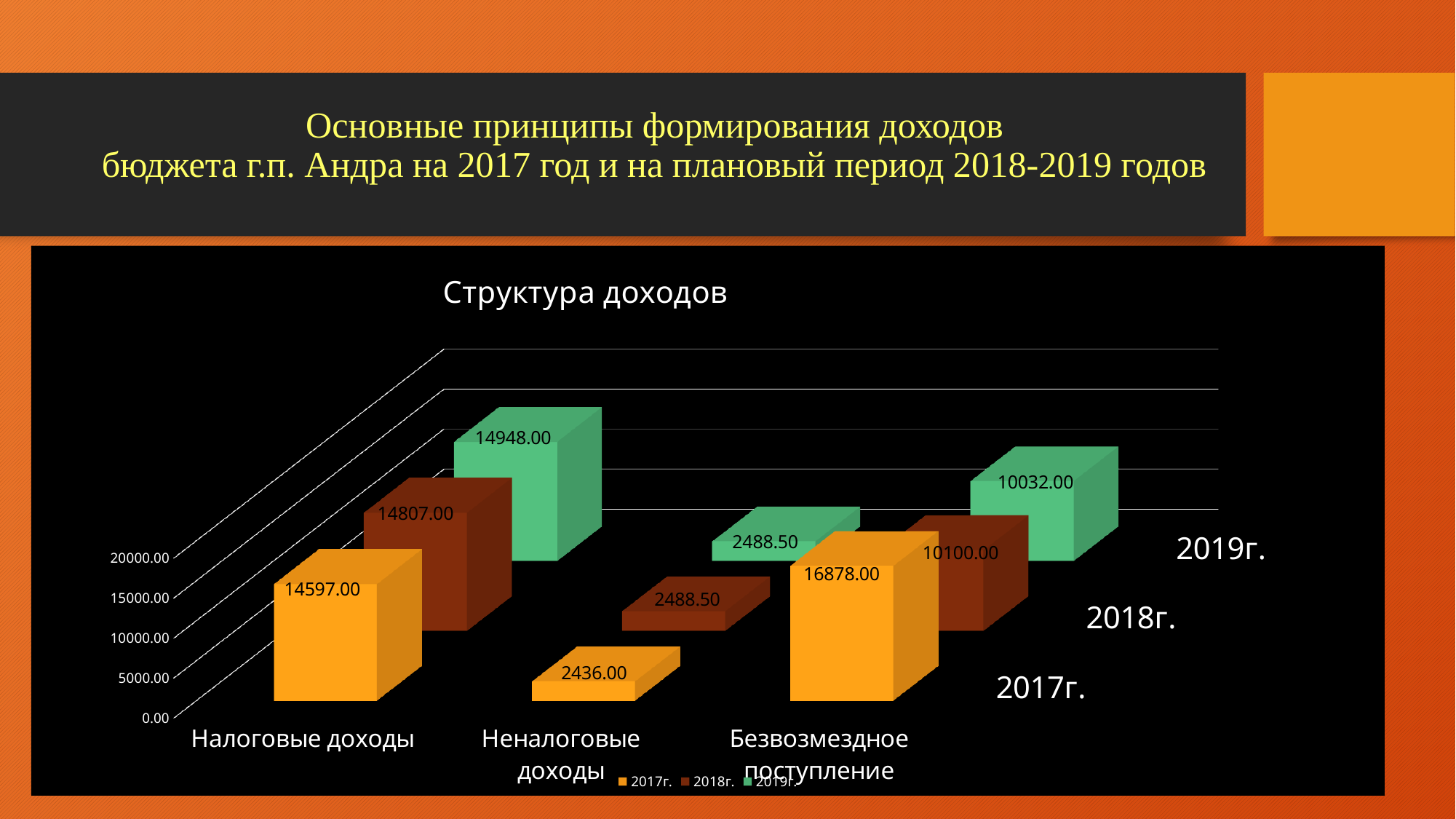
Which category has the lowest value in 2019г.? Неналоговые доходы How many categories are shown on the x axis? 3 What type of chart is shown on the slide? bar chart Which is larger: Налоговые доходы in 2019г. or Безвозмездное поступление in 2019г.? Налоговые доходы How many series does the legend list? 3 What is the value for Безвозмездное поступление in 2019г.? 10032.00 Which category has the highest value in 2017г.? Безвозмездное поступление What is the title of the chart? Структура доходов What is the value for Неналоговые доходы in 2018г.? 2488.50 Do the values for Налоговые доходы rise or fall from 2017г. to 2019г.? rise What is the difference between the 2017г. and 2018г. values for Безвозмездное поступление? 6778.00 What is the value for Налоговые доходы in 2017г.? 14597.00